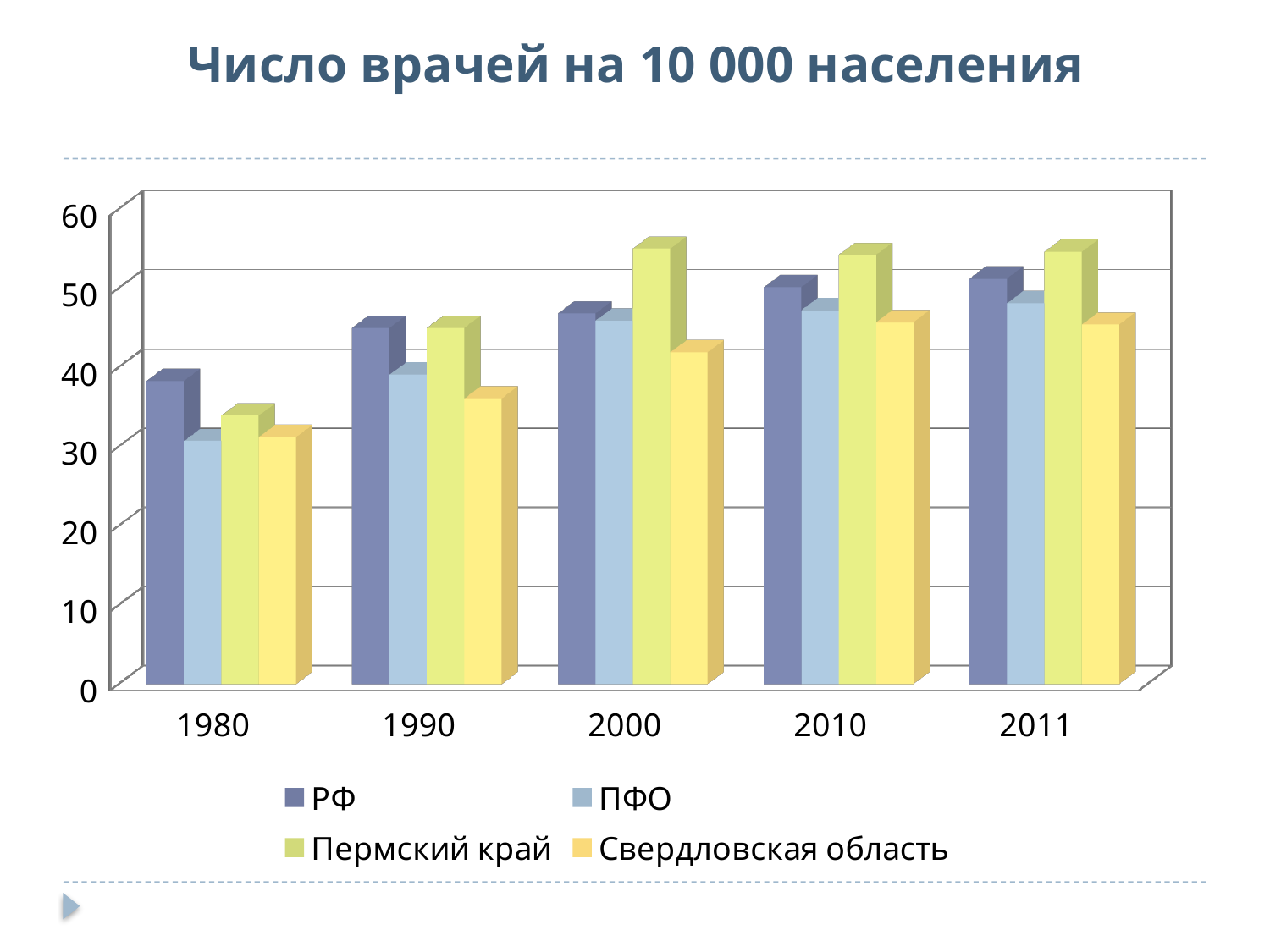
Do the values for РФ rise or fall from 1980 to 2011? rise In 1980, which is larger: the value for РФ or the value for ПФО? РФ What is the title of the chart? Число врачей на 10 000 населения Is the value for РФ in 1980 greater or less than 30? greater Which series has the lowest value in 1990? Свердловская область Is the value for Пермский край in 2000 greater or less than 50? greater Is the value for ПФО in 1980 greater or less than 40? less What kind of chart is shown on the slide? bar chart How many years are shown on the x axis? 5 How many series does the legend list? 4 Which series has the highest value in 2000? Пермский край